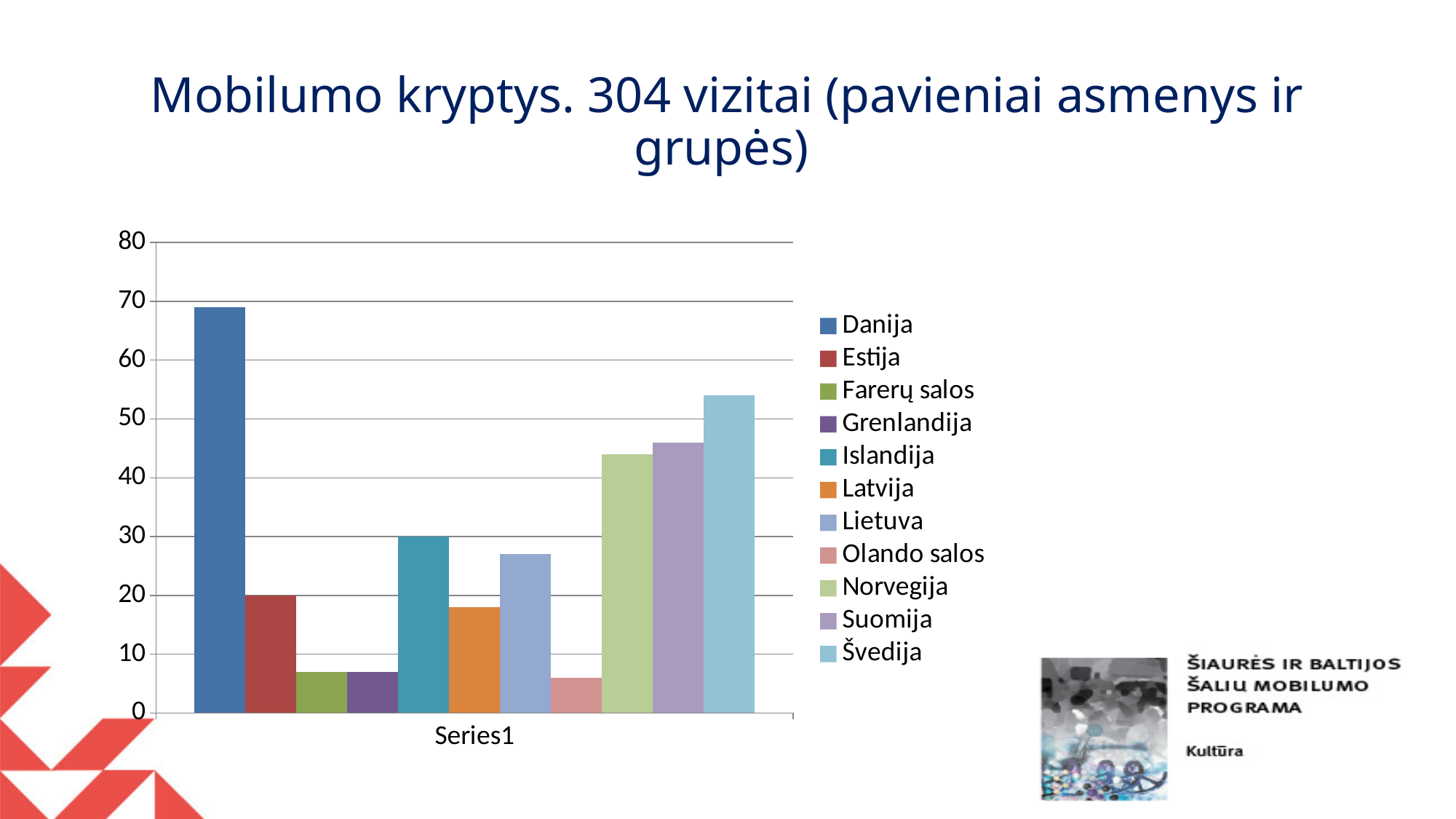
What kind of chart is shown on the slide? bar chart What is the title of the slide containing the chart? Mobilumo kryptys. 304 vizitai (pavieniai asmenys ir grupės) Is the value for Danija greater or less than 60? greater Which country has the highest bar in the chart? Danija What is the value for Islandija? 30 What is the value for Estija? 20 Which is larger, the value for Danija or the value for Švedija? Danija Is the value for Olando salos greater or less than 10? less Is the value for Norvegija greater or less than 40? greater Which is larger, the value for Islandija or the value for Latvija? Islandija How many countries/regions are listed in the chart legend? 11